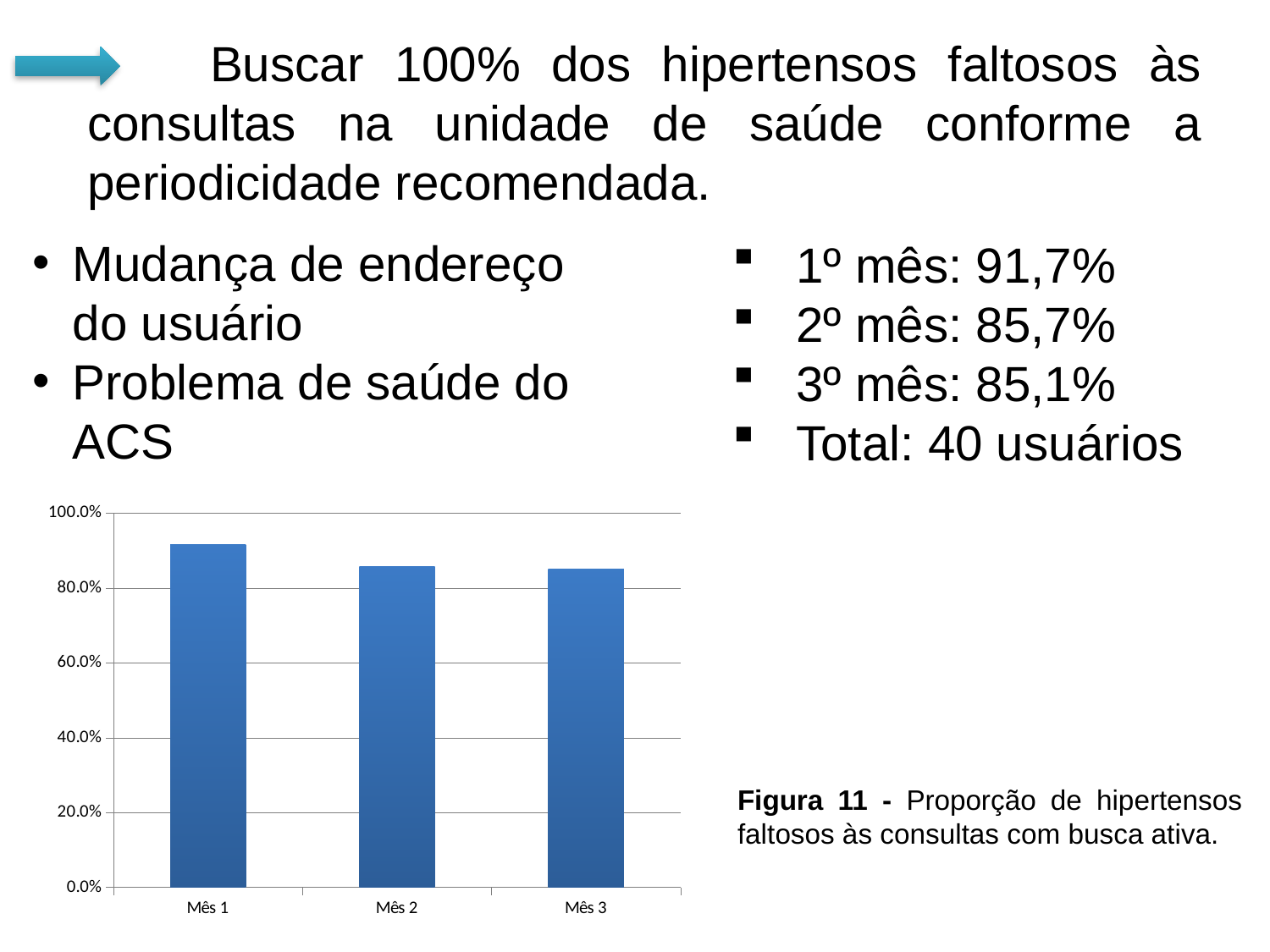
Which is larger, the value for Mês 1 or the value for Mês 3? Mês 1 Is the value for Mês 2 greater or less than 80.0%? greater How many months (categories) are plotted on the x axis of the chart? 3 Is the value for Mês 3 greater or less than 60.0%? greater What kind of chart is shown on the slide? bar chart According to the slide, what proportion is reported for the 1º mês (Mês 1)? 91,7% Do the bar values rise or fall from Mês 1 to Mês 3? fall According to the slide, what proportion is reported for the 3º mês (Mês 3)? 85,1% Which month has the highest bar in the chart? Mês 1 Is the value for Mês 3 greater or less than 100.0%? less What is the highest tick value shown on the chart's vertical axis? 100.0%